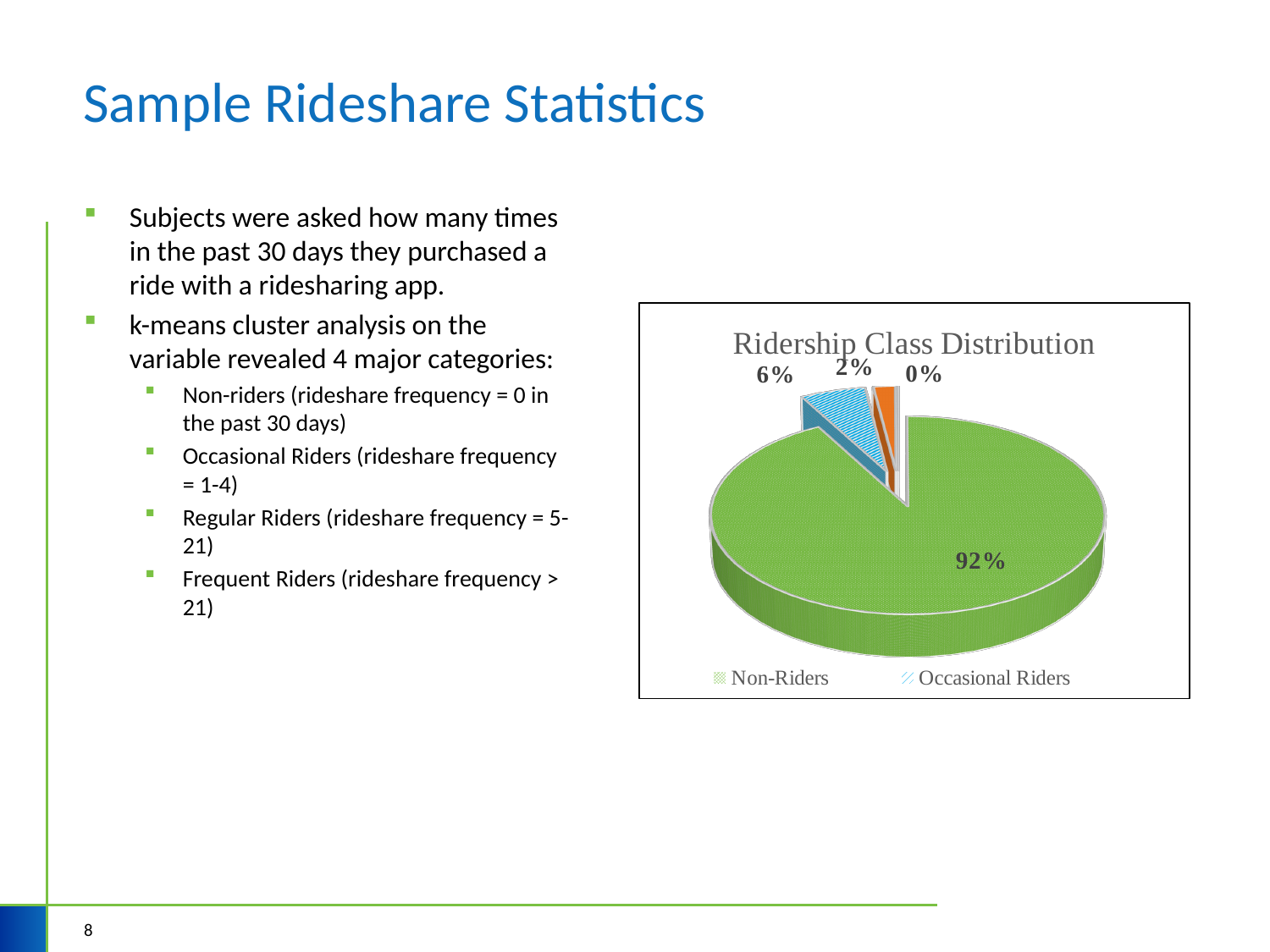
What kind of chart is shown on the slide? pie chart What percentage of the pie is labeled for Non-Riders? 92% Which slice is larger, Non-Riders or Occasional Riders? Non-Riders Which category has the largest slice of the pie? Non-Riders Is the Non-Riders share greater or less than 50%? greater Which two legend entries are visible below the pie? Non-Riders and Occasional Riders How many percentage labels are shown on the pie? 4 What is the difference between the Non-Riders share and the Occasional Riders share? 86% What is the title of the chart? Ridership Class Distribution What percentage of the pie is labeled for Occasional Riders? 6% What is the smallest percentage label shown on the pie? 0% What is the sum of the four percentage labels on the pie? 100%